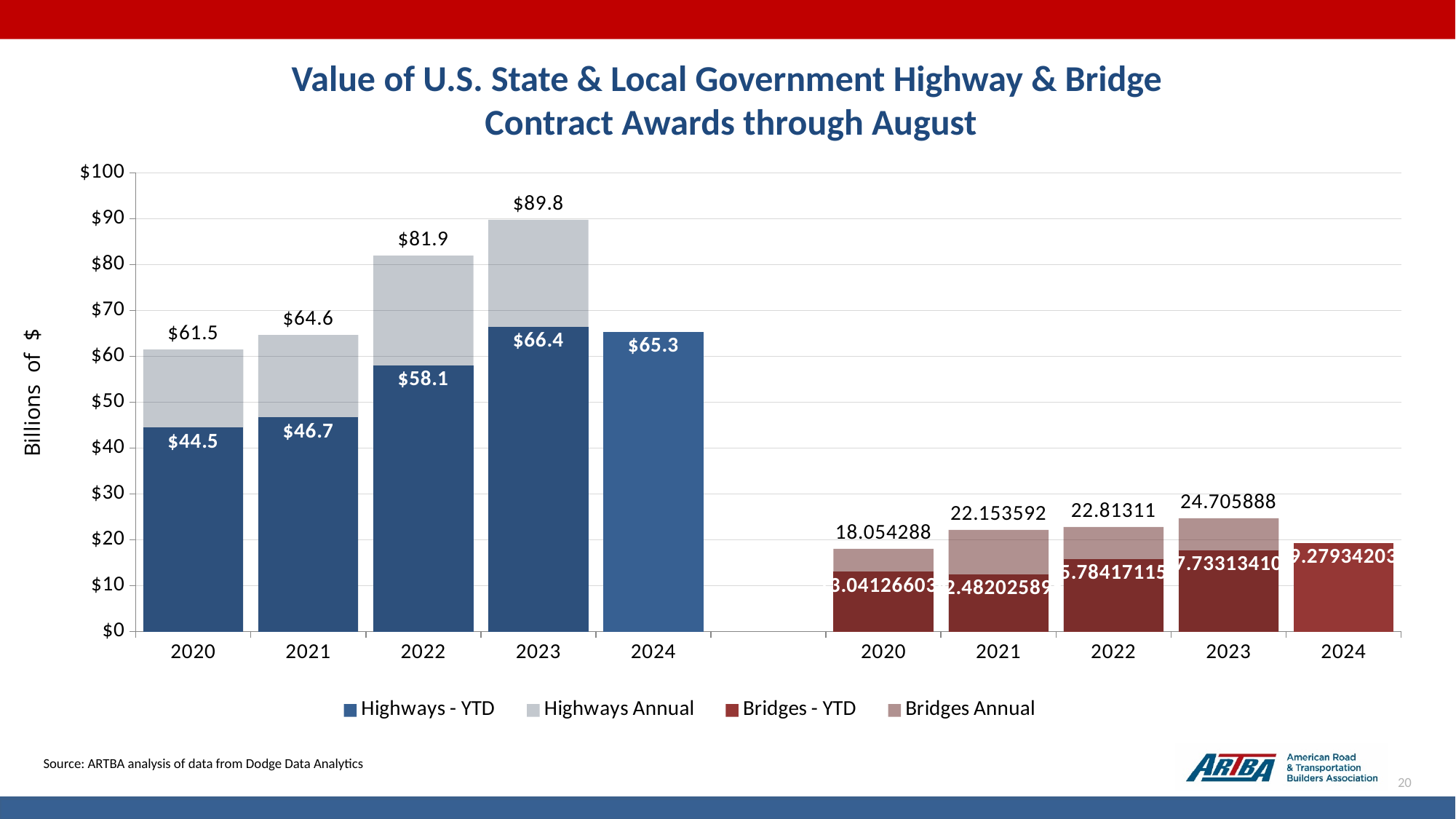
Is the value labeled at the top of the 2024 bridges bar greater or less than $20? less What is the label on the vertical axis? Billions of $ What is the difference between the Highways - YTD values for 2023 and 2020? $21.9 What value is labeled at the top of the 2021 bridges bar? 22.153592 What kind of chart is shown on the slide? Bar chart What is the Highways - YTD value for 2024? $65.3 What is the Highways - YTD value for 2022? $58.1 Is the Highways - YTD value for 2021 larger than the Highways - YTD value for 2020? Yes Which year has the highest Highways - YTD value? 2023 What value is labeled at the top of the 2023 highways bar? $89.8 Which year has the lowest Highways - YTD value? 2020 How many series does the legend list? 4